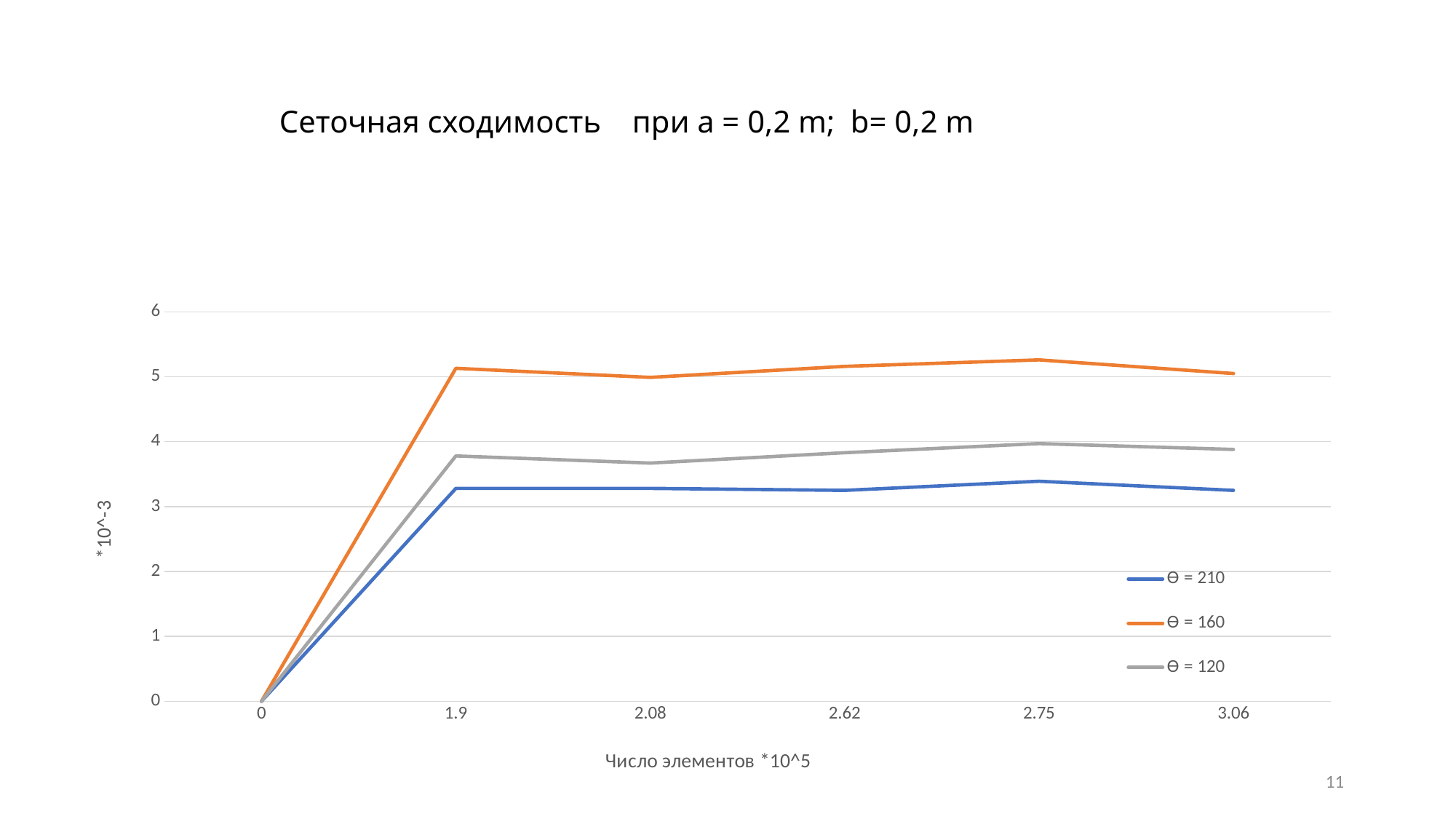
Is the value for Ө = 210 at x = 2.75 greater or less than 3? greater What is the value of all three series at x = 0? 0 Is the value for Ө = 120 at x = 2.08 greater or less than 4? less What is the label of the x axis? Число элементов *10^5 Do the values for Ө = 160 rise or fall between x = 0 and x = 1.9? rise Is the value for Ө = 160 at x = 1.9 greater or less than 5? greater Which is larger at x = 2.62: the value for Ө = 120 or the value for Ө = 210? Ө = 120 How many points are marked along the x axis? 6 How many series does the legend list? 3 What kind of chart is shown on the slide? line chart Which series has the highest values across the chart? Ө = 160 Which series has the lowest values at x = 3.06? Ө = 210